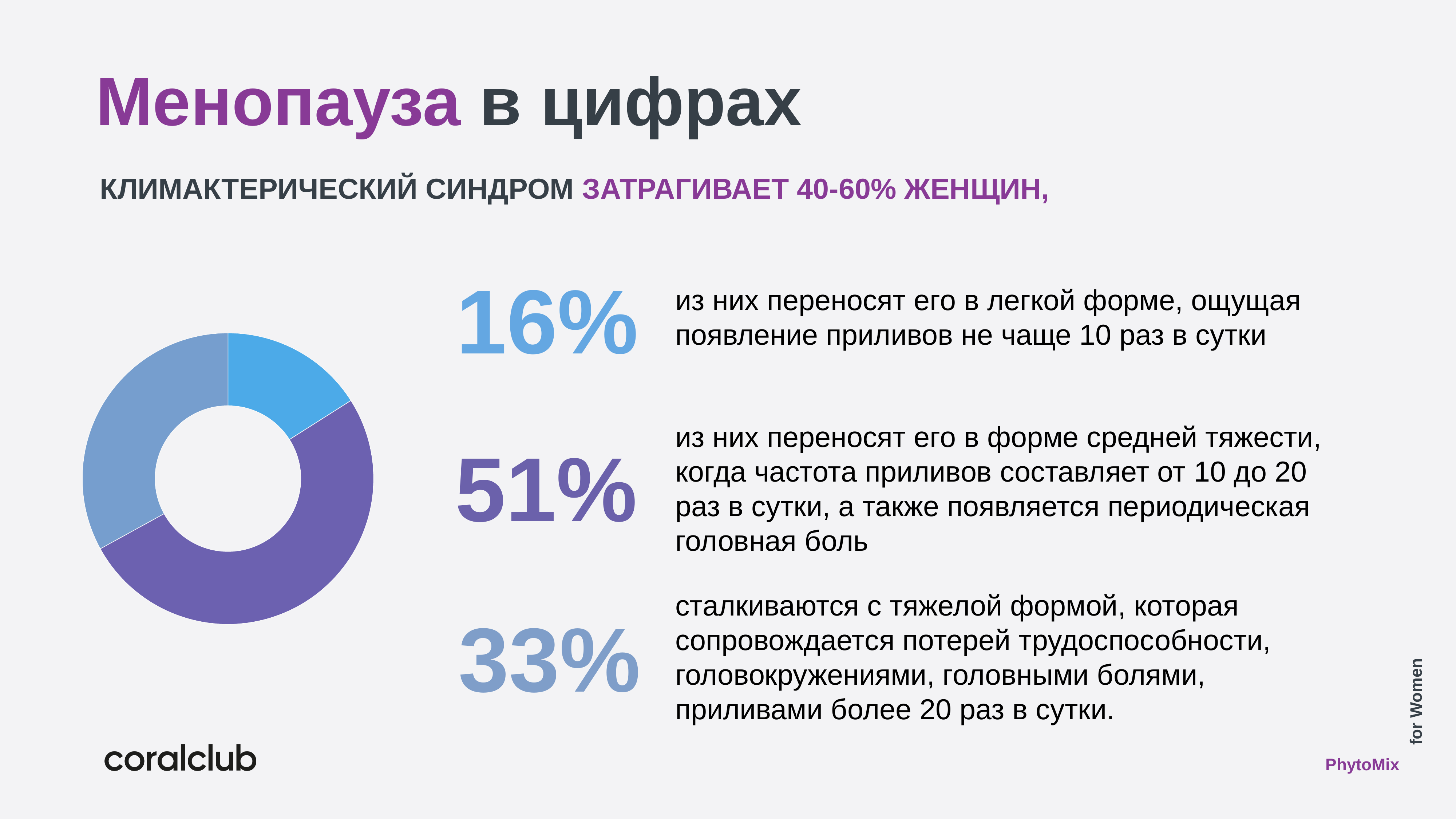
Which form of the syndrome has the smallest share in the donut chart? Mild form (легкая форма), 16% What share of women experience the syndrome in a moderate form (средней тяжести)? 51% What share of women experience the climacteric syndrome in a mild form (легкая форма)? 16% How many slices does the donut chart have? 3 Which colour in the donut chart represents the 16% slice? Light blue Which form of the syndrome has the largest share in the donut chart? Moderate form (средней тяжести), 51% What is the difference between the share for the moderate form and the share for the mild form? 35% What kind of chart is shown on the slide? Pie (donut) chart What share of women face the severe form (тяжелая форма)? 33% Which is larger: the share for the severe form or the share for the mild form? Severe form (33%) What do the three percentages in the donut chart add up to? 100% Which colour in the donut chart represents the 51% slice? Purple